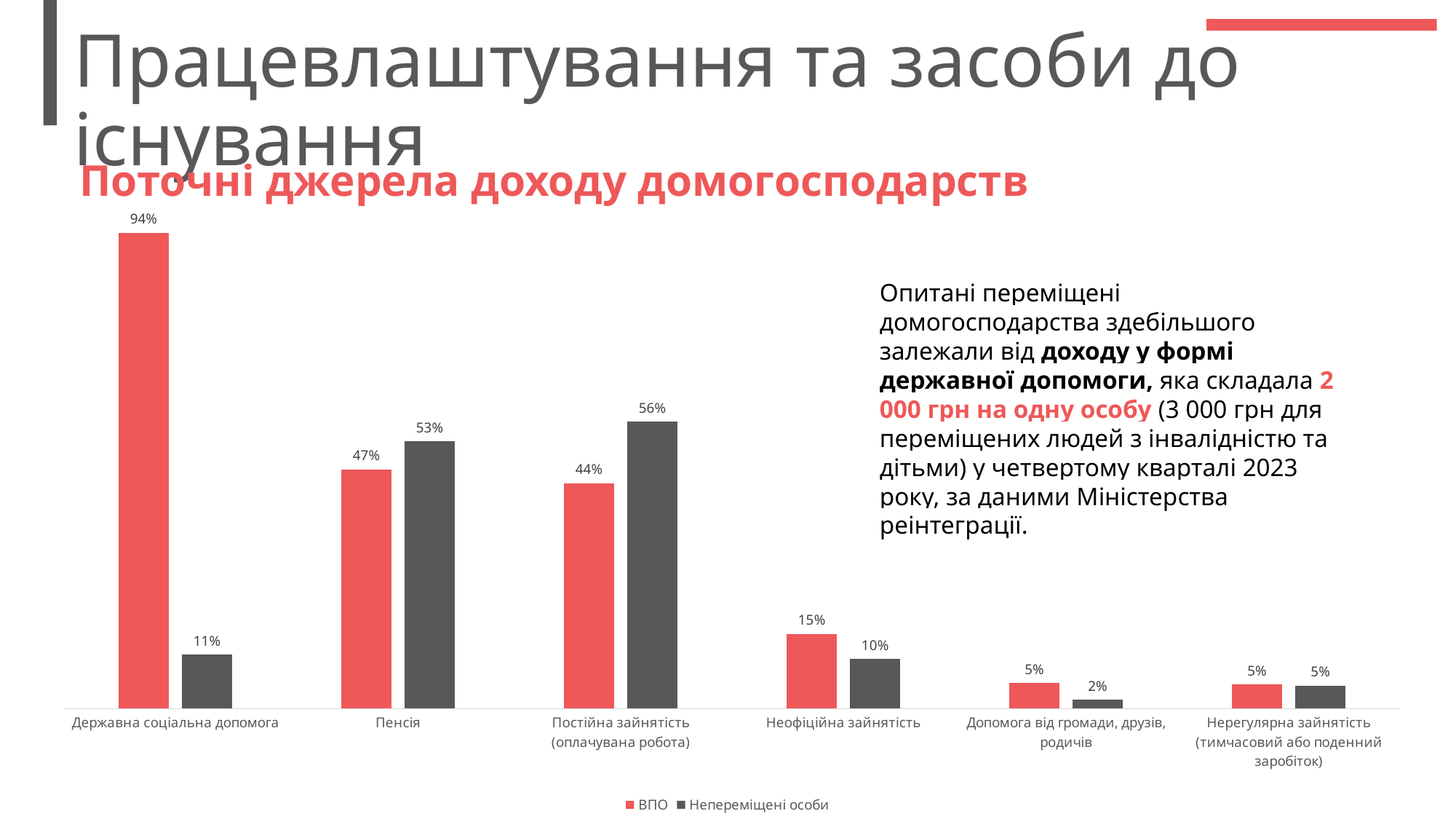
Which category has the highest value for ВПО? Державна соціальна допомога What is the difference between the ВПО and Непереміщені особи values for Державна соціальна допомога? 83% What is the value for Непереміщені особи in the Пенсія category? 53% What is the value for ВПО in the Державна соціальна допомога category? 94% Which colour represents the ВПО series? Red How many series does the legend list? 2 What is the value for ВПО in the Неофіційна зайнятість category? 15% How many categories are shown on the x axis? 6 For Постійна зайнятість (оплачувана робота), which series has the larger value, ВПО or Непереміщені особи? Непереміщені особи What is the title of the chart? Поточні джерела доходу домогосподарств What kind of chart is shown on the slide? Bar chart Which category has the lowest value for Непереміщені особи? Допомога від громади, друзів, родичів